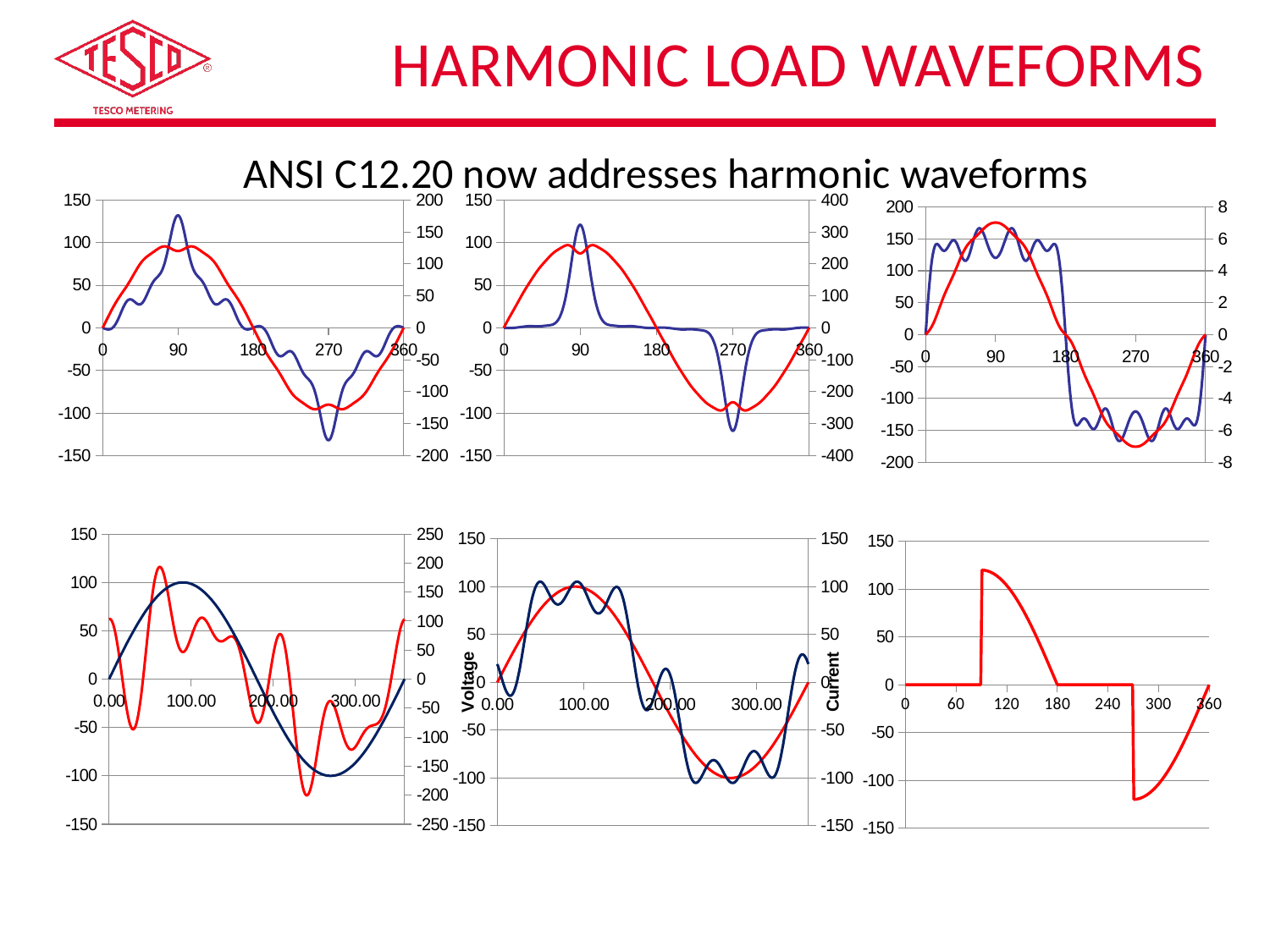
In the top-right chart, is the peak of the red line greater or less than 150 on the left axis? greater In the bottom-right chart, is the peak value of the red line greater or less than 100? greater What kind of chart is the bottom-right chart on the slide? line chart How many charts are shown on the slide? 6 How many lines are plotted in the bottom-right chart? 1 In the bottom-right chart, what is the largest tick value shown on the x axis? 360 In the bottom-middle chart, what is the title of the left vertical axis? Voltage In the bottom-middle chart, what is the title of the right vertical axis? Current In the bottom-right chart, does the red line rise or fall between x = 120 and x = 180? fall In the bottom-right chart, is the lowest value of the red line greater or less than -100? less How many lines are plotted in the top-left chart? 2